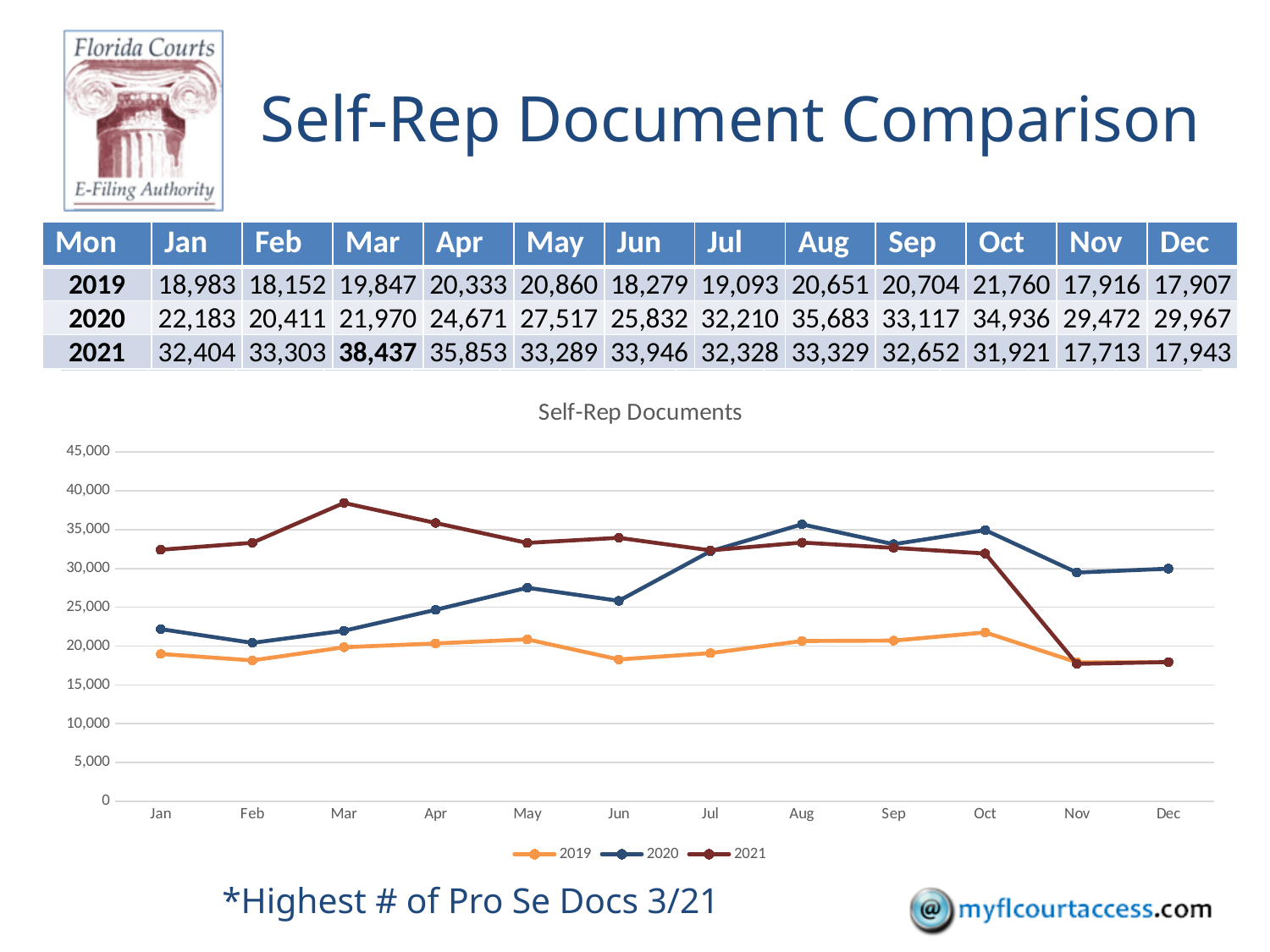
Is the 2020 value for July greater or less than 30,000? greater Does the 2021 series rise or fall from October to November? fall What is the 2021 value for March in the Self-Rep Documents chart? 38,437 How many series does the legend of the Self-Rep Documents chart list? 3 In which month does the 2021 series reach its highest value? Mar What is the 2020 value for August in the Self-Rep Documents chart? 35,683 What kind of chart is the Self-Rep Documents chart? line chart In which month does the 2021 series reach its lowest value? Nov Which is larger in August: the 2020 value or the 2019 value? 2020 How many months are plotted along the x axis of the Self-Rep Documents chart? 12 What is the difference between the 2021 and 2020 values for March? 16,467 What is the 2019 value for October in the Self-Rep Documents chart? 21,760